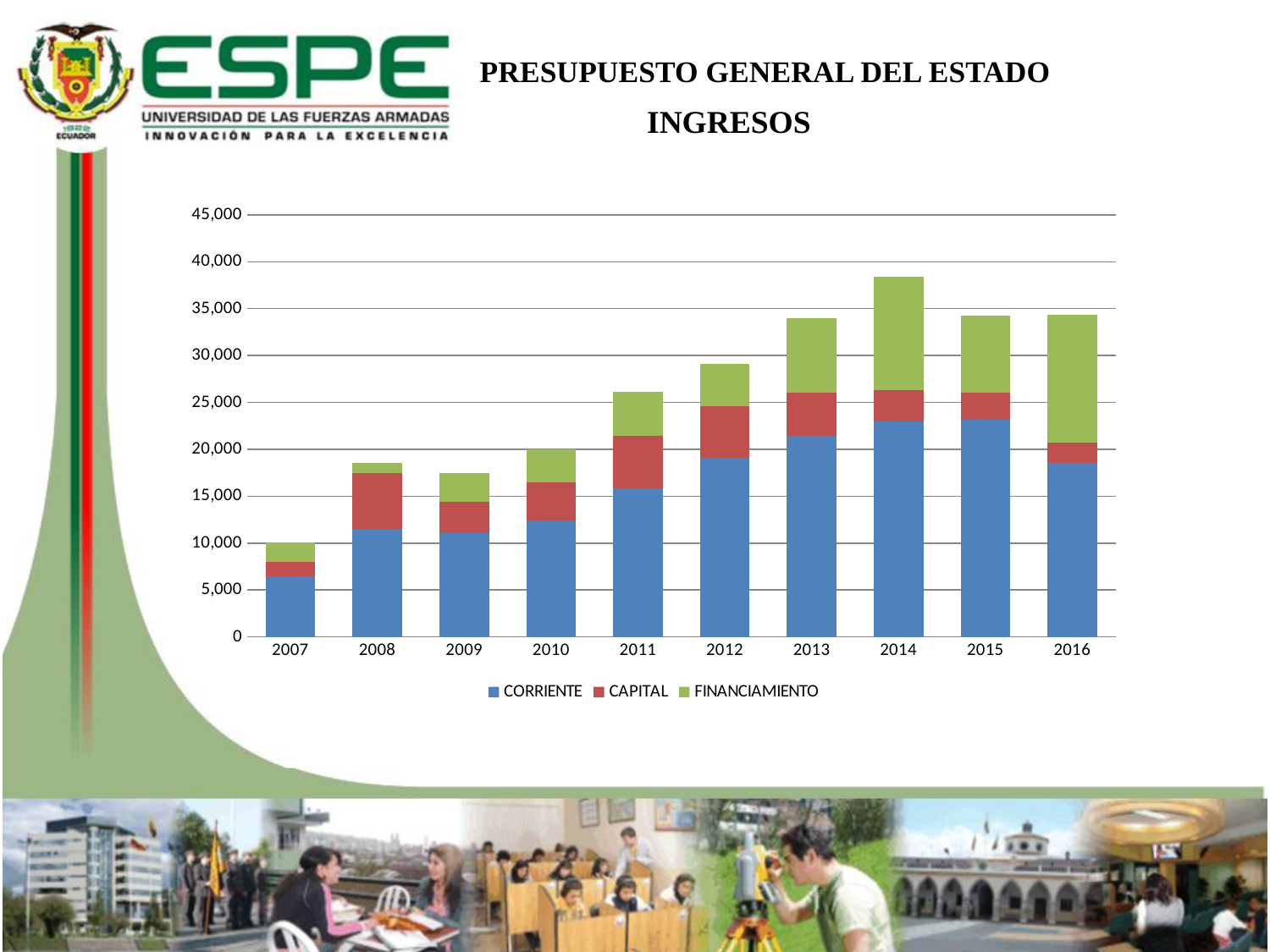
How many years are shown on the x axis of the chart? 10 Which year has the lowest total bar in the chart? 2007 Which series are listed in the chart's legend? CORRIENTE, CAPITAL, FINANCIAMIENTO Is the total bar for 2014 greater or less than 35,000? greater Do the total bars generally rise or fall from 2007 to 2014? rise Is the CORRIENTE value for 2016 greater or less than 20,000? less Is the total bar for 2013 greater or less than 30,000? greater How many series does the chart's legend list? 3 Which year has the highest total bar in the chart? 2014 Which year has the larger total bar, 2013 or 2014? 2014 What kind of chart is shown on the slide? Stacked bar chart